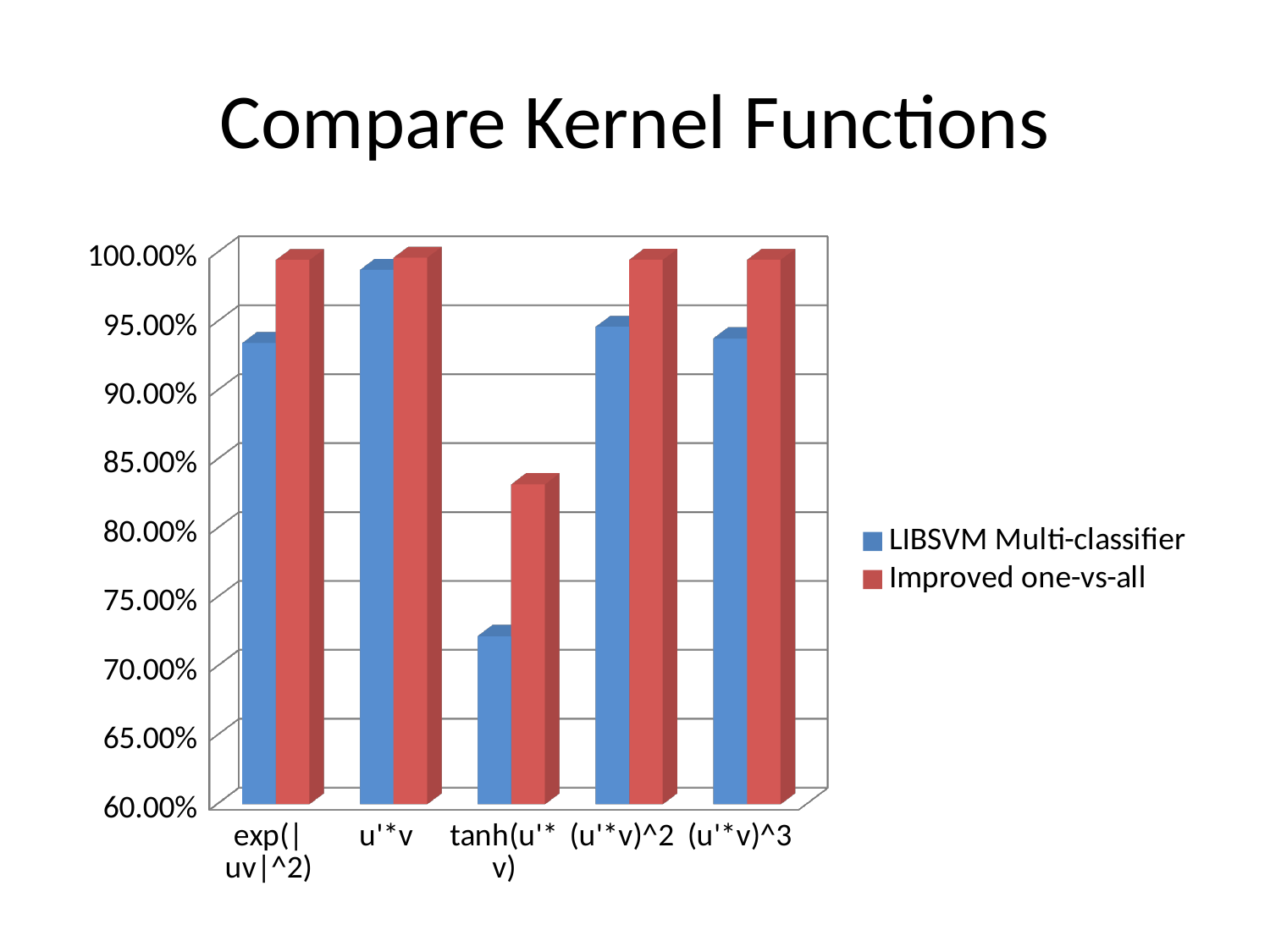
Is the Improved one-vs-all value for tanh(u'*v) greater or less than 80.00%? greater Which kernel function has the lowest value for the Improved one-vs-all series? tanh(u'*v) Is the LIBSVM Multi-classifier value for u'*v greater or less than 95.00%? greater What kind of chart is shown on the slide? bar chart For tanh(u'*v), which series has the larger value, LIBSVM Multi-classifier or Improved one-vs-all? Improved one-vs-all Is the LIBSVM Multi-classifier value for tanh(u'*v) greater or less than 75.00%? less Which kernel function has the highest value for the LIBSVM Multi-classifier series? u'*v How many series does the legend list? 2 Which kernel function has the lowest value for the LIBSVM Multi-classifier series? tanh(u'*v) What is the title of the chart? Compare Kernel Functions How many kernel function categories are shown on the x axis? 5